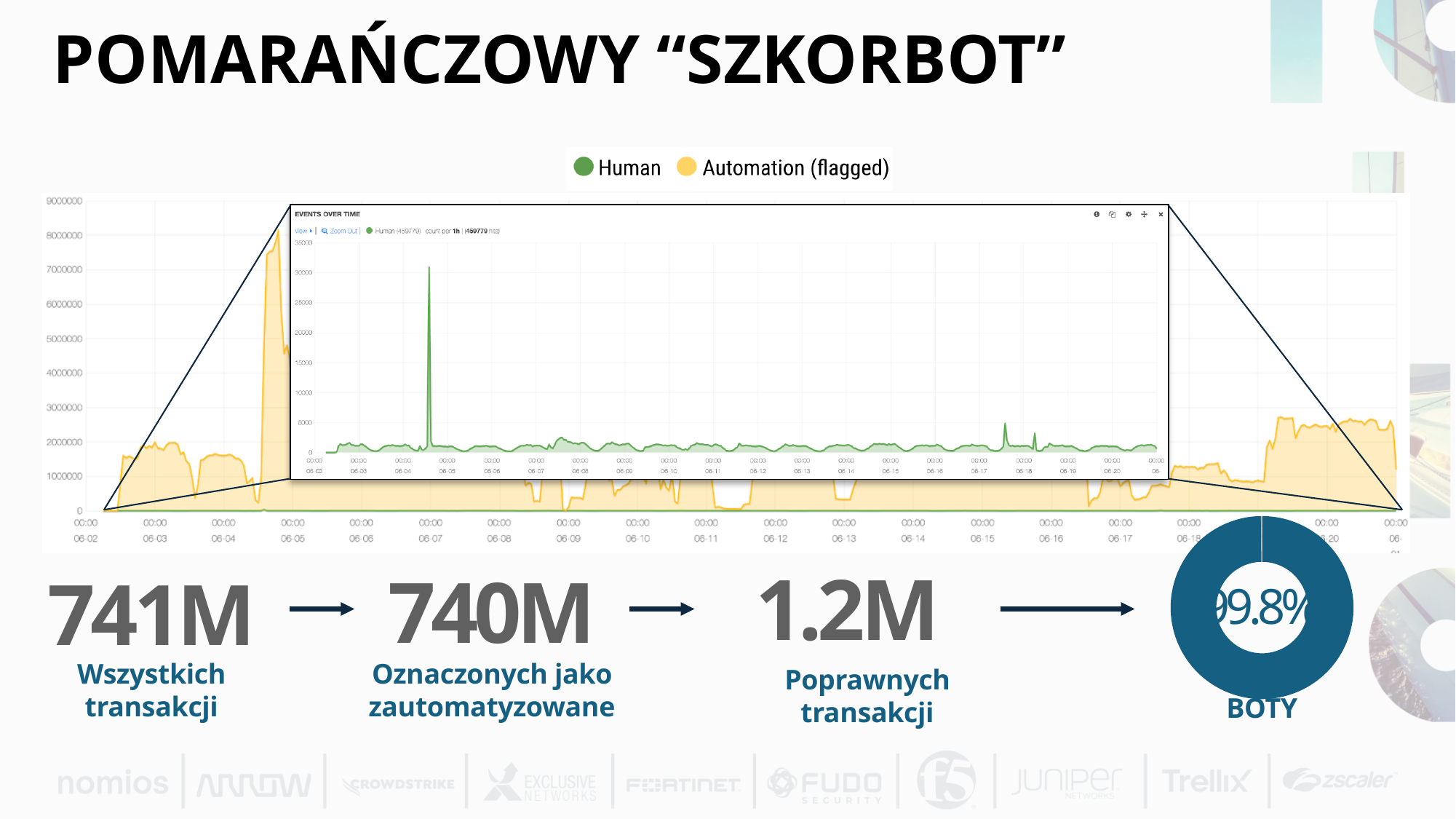
What is the title of the inset chart? EVENTS OVER TIME In the inset EVENTS OVER TIME chart, is the peak Human value greater or less than 25000? greater What percentage is shown in the donut chart labelled BOTY? 99.8% In the large chart, how many series does the legend list? 2 In the large chart, is the Automation (flagged) value around 06-19 greater or less than 2000000? greater In the large chart, which series has the higher values across the period, Human or Automation (flagged)? Automation (flagged) In the inset EVENTS OVER TIME chart, what is the highest value shown on the y axis? 35000 What kind of chart is the BOTY chart at the bottom right? donut chart In the large chart, what is the highest value shown on the y axis? 9000000 In the large chart, is the peak value of Automation (flagged) around 06-04/06-05 greater or less than 7000000? greater What kind of chart is the large chart with the Human and Automation (flagged) legend? area chart In the large chart, what are the two series named in the legend? Human and Automation (flagged)